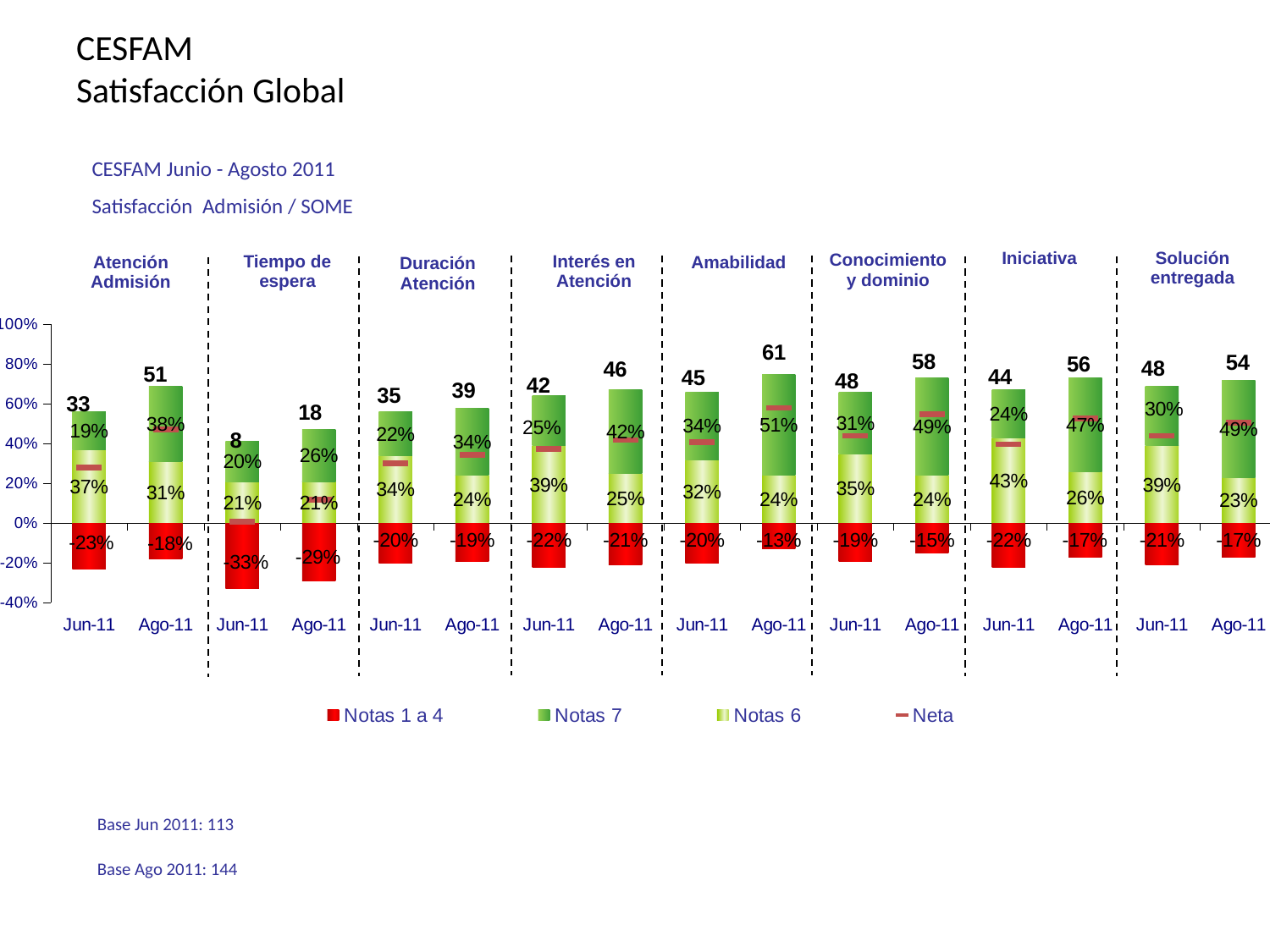
What is the difference between the Neta values for Atención Admisión in Ago-11 and Jun-11? 18 Which attribute has the lowest Neta value in Jun-11? Tiempo de espera Which attribute has the highest Neta value in Ago-11? Amabilidad How many series does the legend list? 4 What is the Notas 6 percentage for Iniciativa in Jun-11? 43% Which is larger, the Notas 7 percentage for Conocimiento y dominio in Ago-11 or in Jun-11? Ago-11 How many attributes are shown along the x axis of the chart? 8 What is the Notas 7 percentage for Tiempo de espera in Jun-11? 20% What is the Notas 1 a 4 percentage for Tiempo de espera in Jun-11? -33% What kind of chart is shown on the slide? bar chart Which legend entry is shown in red? Notas 1 a 4 What is the Neta value for Amabilidad in Ago-11? 61